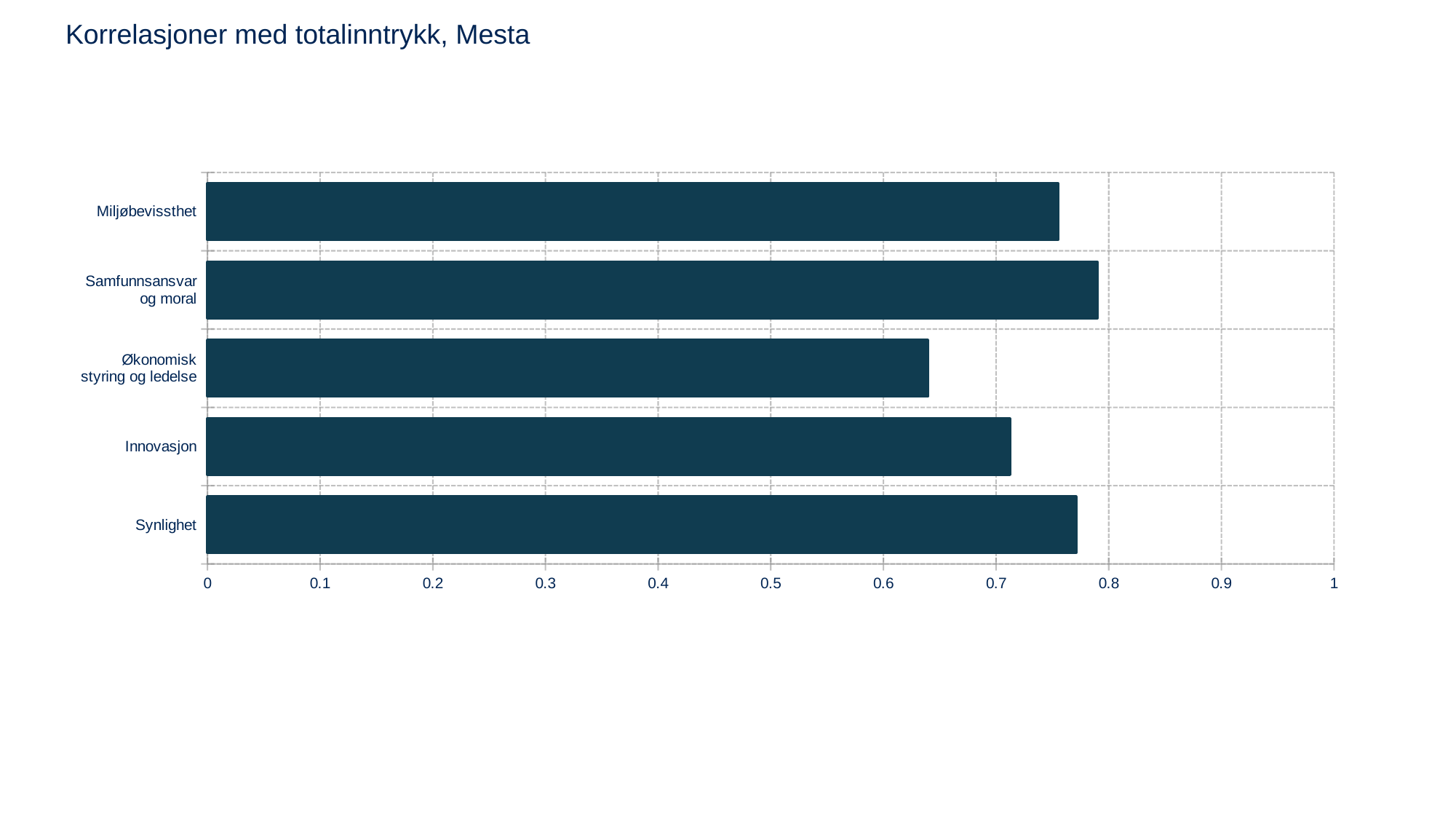
What is the title of the chart? Korrelasjoner med totalinntrykk, Mesta Which is larger, the value for Miljøbevissthet or the value for Innovasjon? Miljøbevissthet Which is larger, the value for Økonomisk styring og ledelse or the value for Synlighet? Synlighet Is the value for Miljøbevissthet greater or less than 0.7? greater Is the value for Synlighet greater or less than 0.7? greater What kind of chart is shown on the slide? bar chart Is the value for Økonomisk styring og ledelse greater or less than 0.7? less Which category has the highest value? Samfunnsansvar og moral How many categories are plotted in the chart? 5 Which category has the lowest value? Økonomisk styring og ledelse